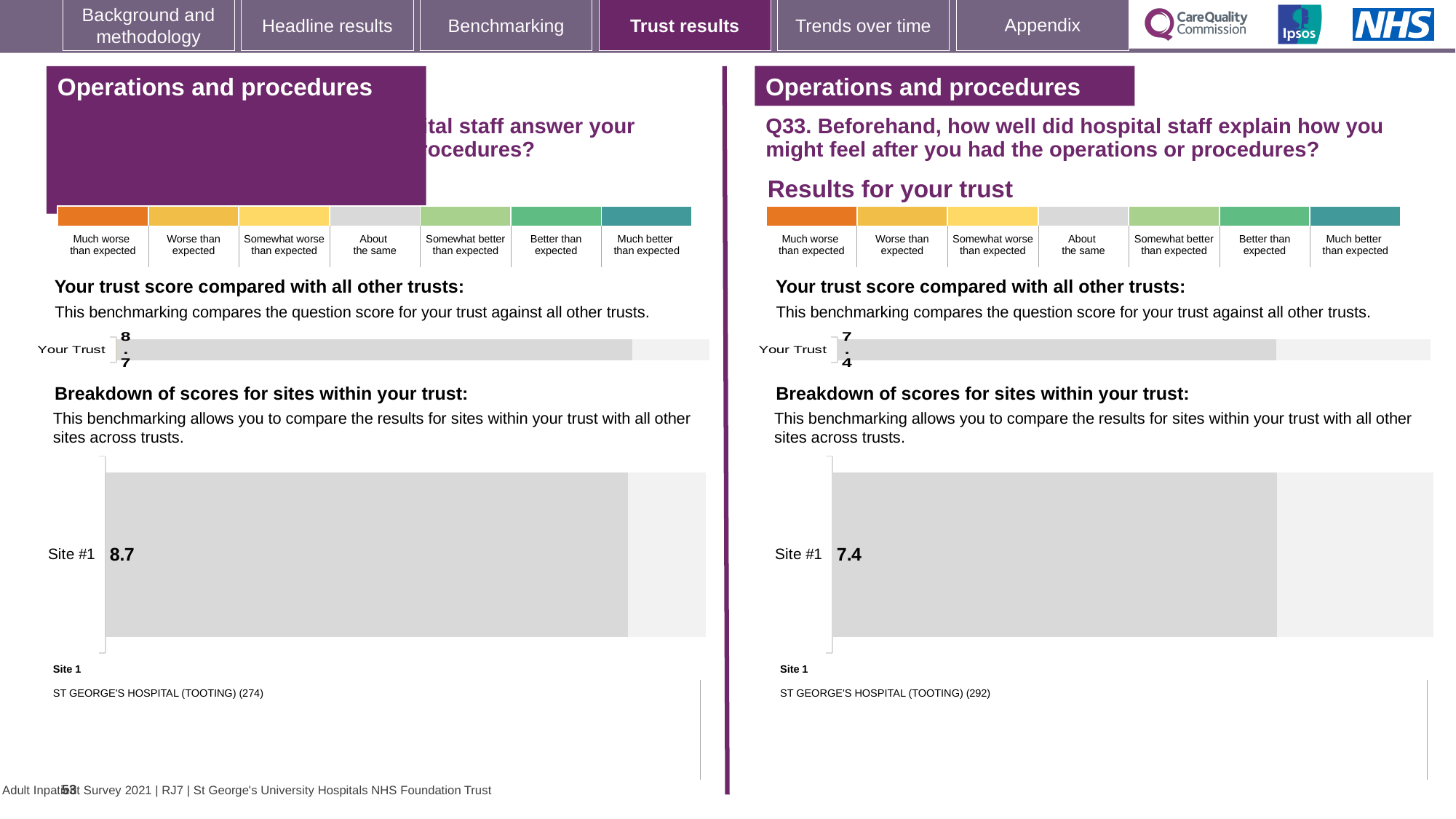
On the left half of the slide, how many sites are shown in the 'Breakdown of scores for sites within your trust' chart? 1 On the left half of the slide, what is the score shown for Your Trust in the 'Your trust score compared with all other trusts' chart? 8.7 On the right half of the slide (Q33), what score is shown for Site #1 in the 'Breakdown of scores for sites within your trust' chart? 7.4 On the right half of the slide (Q33), is the Site #1 score greater or less than the Site #1 score on the left half of the slide? less On the left half of the slide, which hospital is listed as Site 1 below the site breakdown chart? ST GEORGE'S HOSPITAL (TOOTING) (274) What type of chart is used to show the Site #1 score on the right half of the slide (Q33)? bar chart On the right half of the slide (Q33), how many sites are shown in the 'Breakdown of scores for sites within your trust' chart? 1 On the right half of the slide (Q33), which hospital is listed as Site 1 below the site breakdown chart? ST GEORGE'S HOSPITAL (TOOTING) (292) On the left half of the slide, what score is shown for Site #1 in the 'Breakdown of scores for sites within your trust' chart? 8.7 Which half of the slide shows the higher Your Trust score, the left chart or the right (Q33) chart? the left chart What is the difference between the Your Trust score on the left half of the slide and the Your Trust score on the right half (Q33)? 1.3 On the right half of the slide (Q33), what is the score shown for Your Trust in the 'Your trust score compared with all other trusts' chart? 7.4